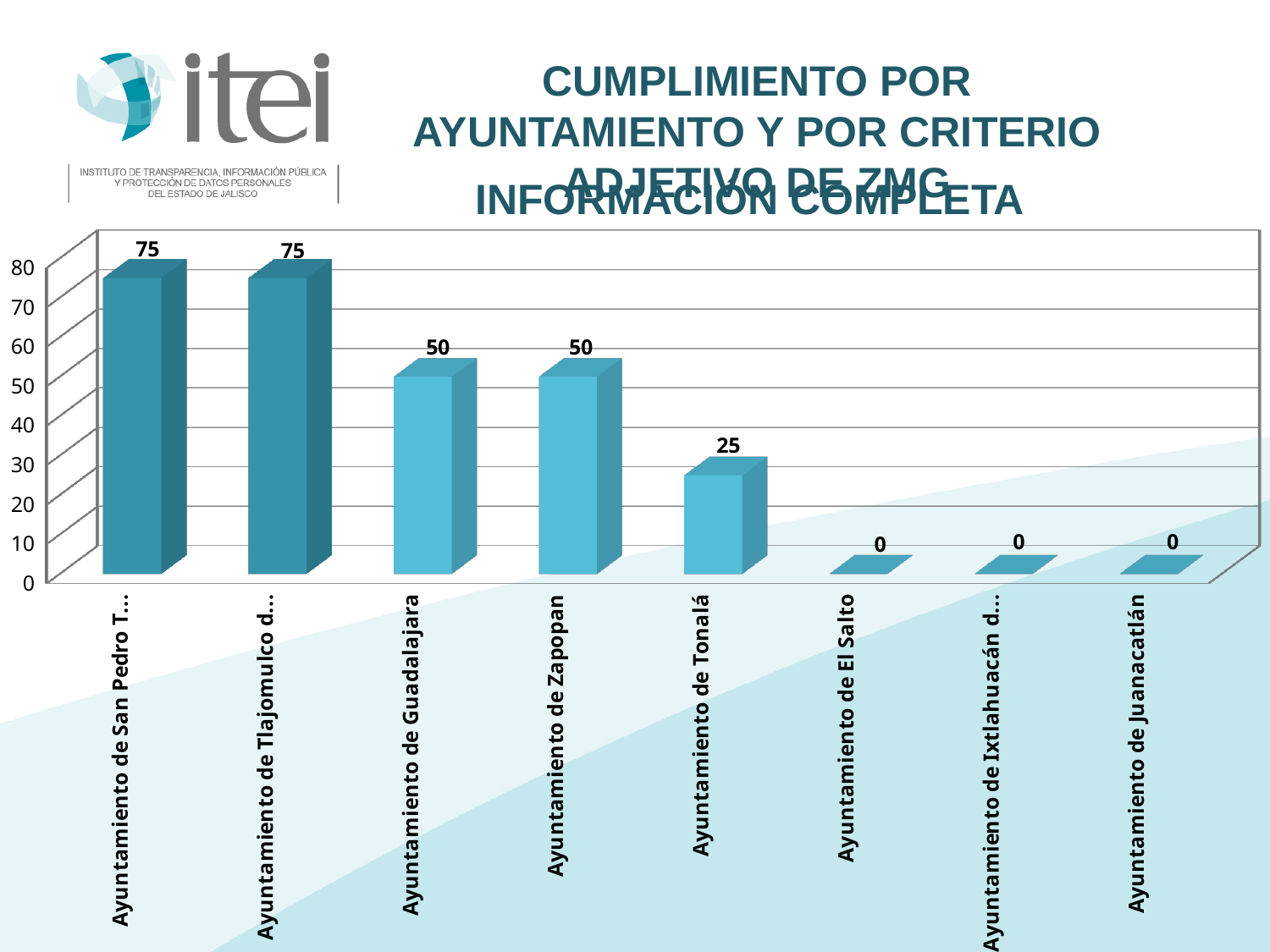
Do the values rise or fall from left to right along the x axis? fall What is the value for Ayuntamiento de Tonalá? 25 What is the difference between the values for Ayuntamiento de Guadalajara and Ayuntamiento de Tonalá? 25 What is the value for Ayuntamiento de Zapopan? 50 Is the value for Ayuntamiento de Tonalá greater or less than 40? less What is the highest value shown in the chart? 75 What is the value for Ayuntamiento de Guadalajara? 50 What is the value for Ayuntamiento de El Salto? 0 How many categories (ayuntamientos) are shown in the chart? 8 What is the value for Ayuntamiento de Juanacatlán? 0 Which has a larger value, Ayuntamiento de Zapopan or Ayuntamiento de Tonalá? Ayuntamiento de Zapopan What kind of chart is shown on the slide? bar chart